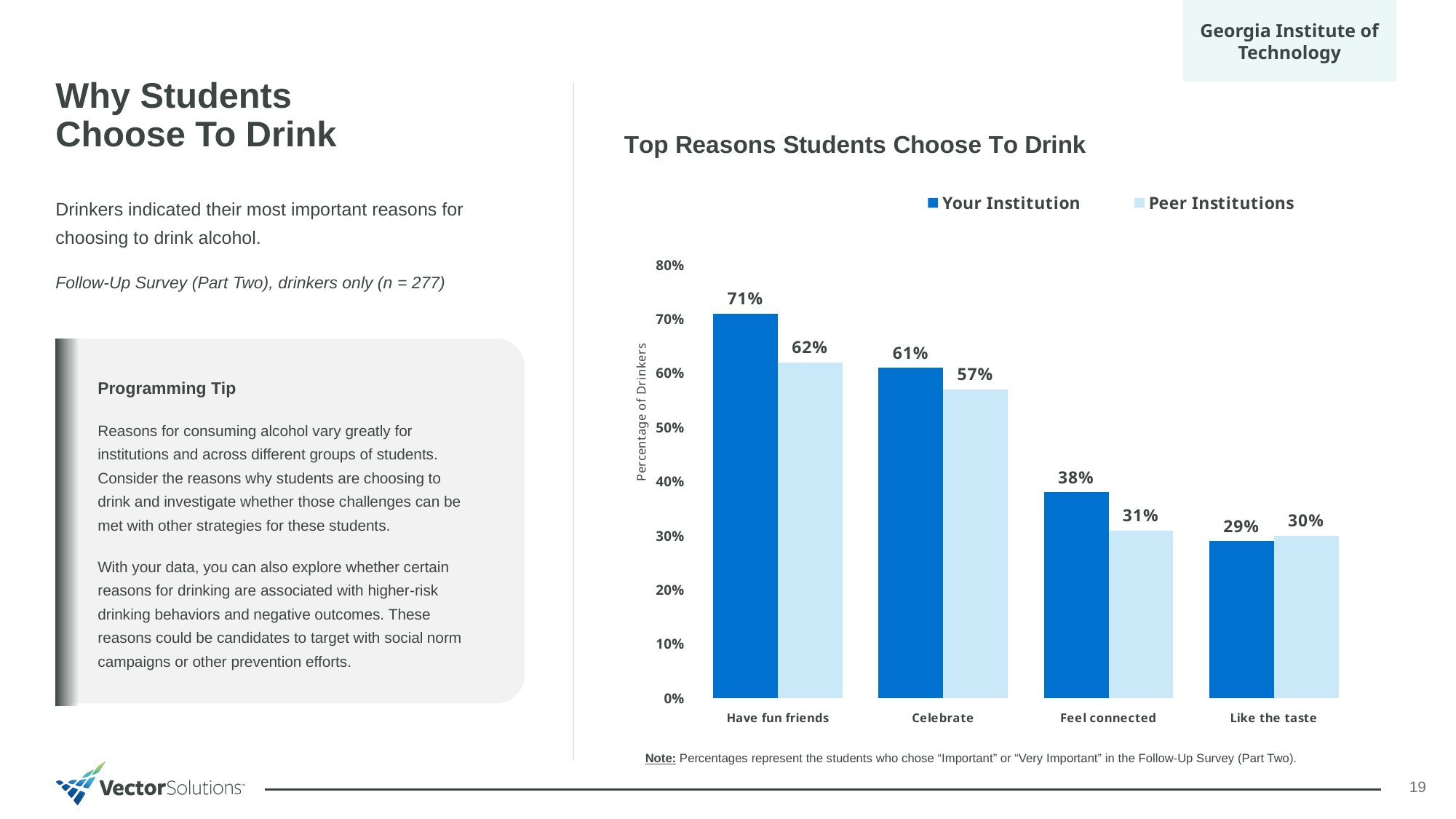
What is the value for Your Institution for Have fun friends? 71% What is the value for Your Institution for Feel connected? 38% Which is larger for Feel connected: Your Institution or Peer Institutions? Your Institution How many series does the legend list? 2 What is the difference between Your Institution and Peer Institutions for Have fun friends? 9% What is the value for Peer Institutions for Celebrate? 57% Which category has the highest value for Your Institution? Have fun friends What is the value for Peer Institutions for Like the taste? 30% What kind of chart is shown? Bar chart What is the title of the chart? Top Reasons Students Choose To Drink How many categories are shown on the x axis? 4 Which category has the lowest value for Peer Institutions? Like the taste